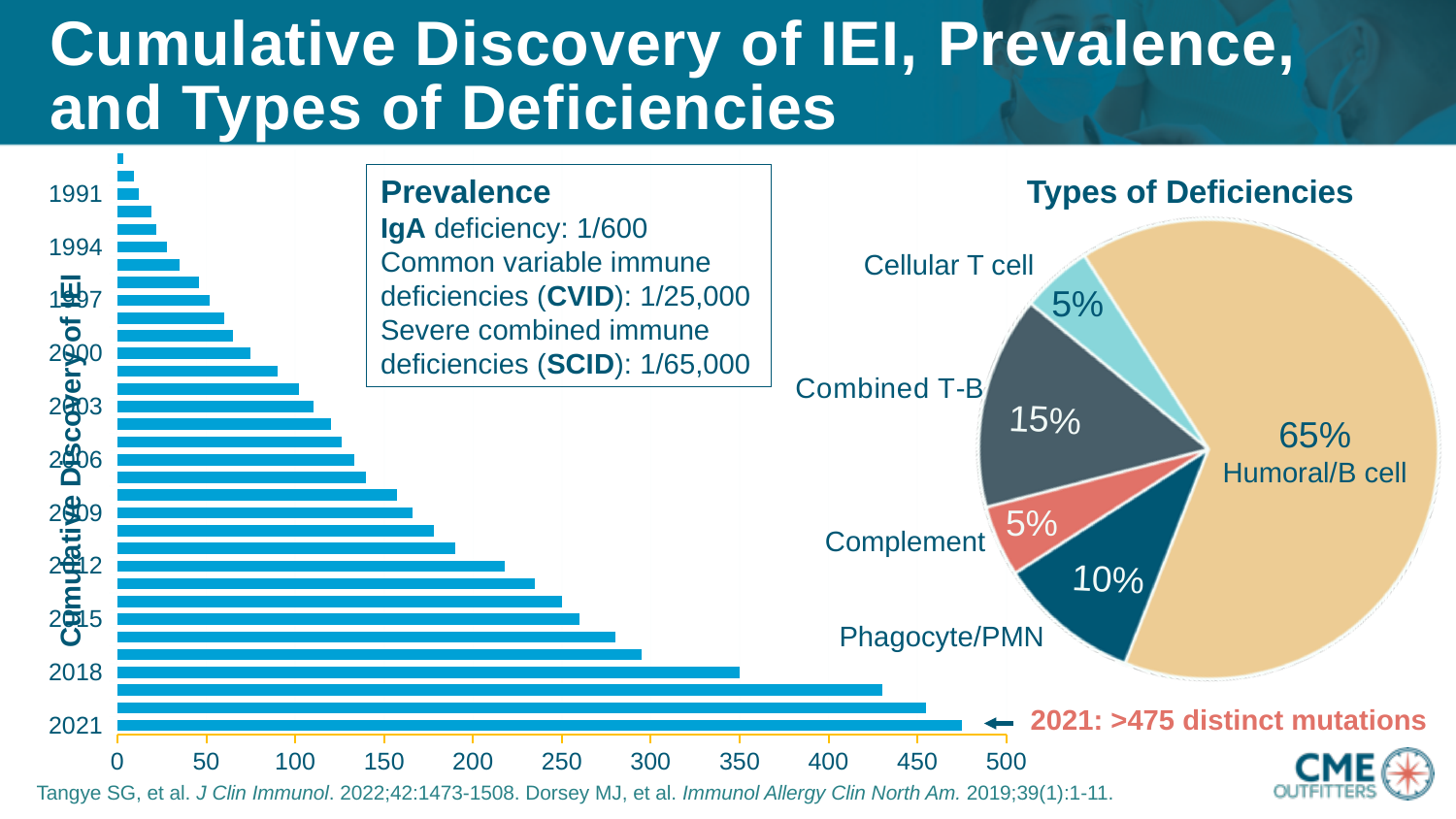
In the Types of Deficiencies pie chart, what percentage is shown for Combined T-B? 15% In the Cumulative Discovery of IEI bar chart, do the bars get longer or shorter as the years go from 1991 to 2021? Longer What is the title of the pie chart on the right of the slide? Types of Deficiencies In the Types of Deficiencies pie chart, which category has the largest slice? Humoral/B cell How many slices does the Types of Deficiencies pie chart have? 5 In the Types of Deficiencies pie chart, which is larger: Combined T-B or Phagocyte/PMN? Combined T-B What type of chart is the Cumulative Discovery of IEI chart on the left of the slide? Bar chart In the Types of Deficiencies pie chart, what percentage is shown for Humoral/B cell? 65% In the Cumulative Discovery of IEI bar chart, is the value for 2021 greater or less than 450? greater In the Cumulative Discovery of IEI bar chart, is the value for 1991 greater or less than 50? less In the Types of Deficiencies pie chart, what percentage is shown for Phagocyte/PMN? 10% In the Types of Deficiencies pie chart, what is the difference in percentage points between Humoral/B cell and Combined T-B? 50%